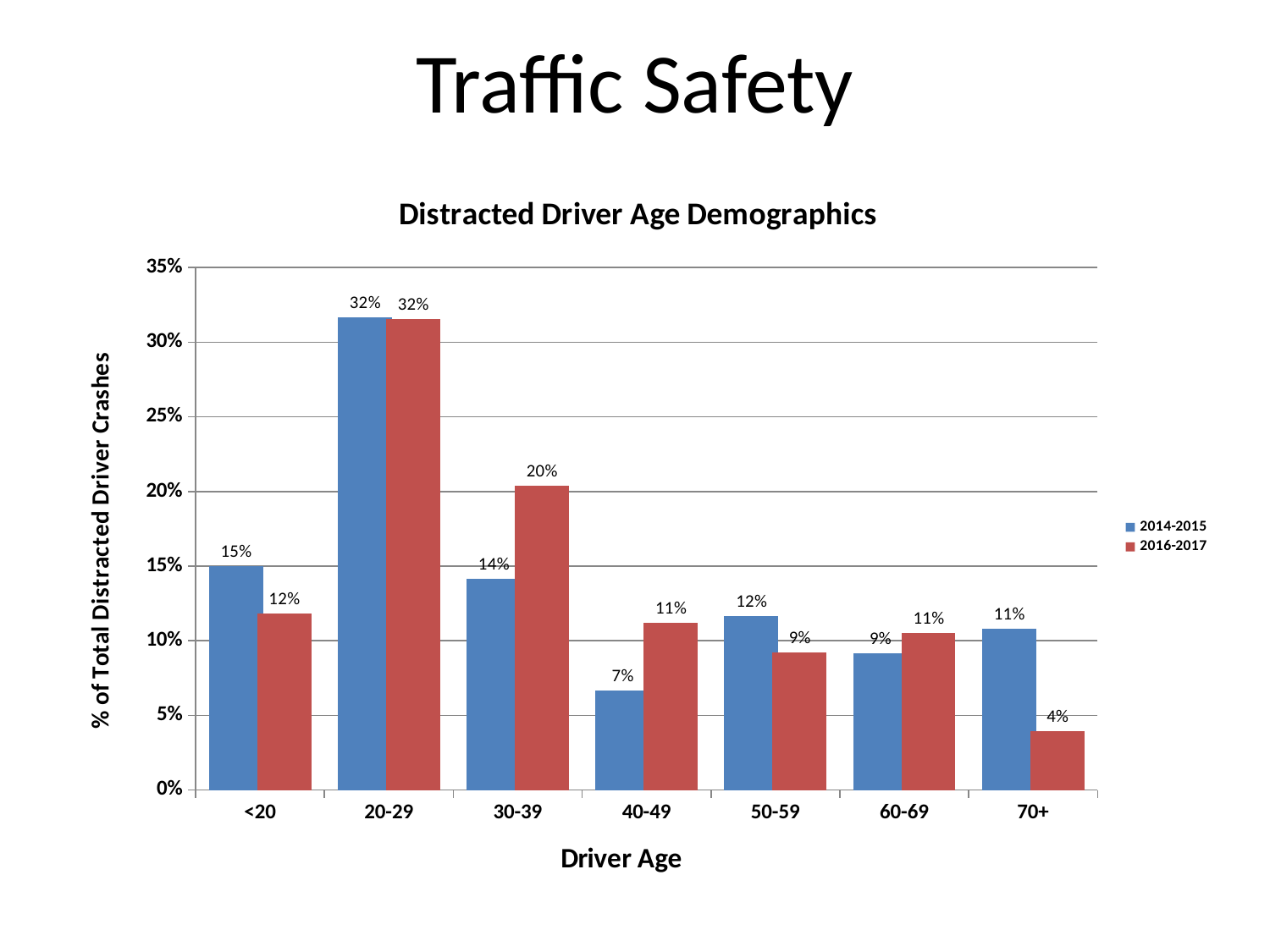
What is the difference between the 2016-2017 and 2014-2015 values for the 30-39 age group? 6 percentage points In the 50-59 age group, which series has the larger value, 2014-2015 or 2016-2017? 2014-2015 How many age groups are shown on the x axis? 7 What kind of chart is shown on the slide? Bar chart How many series does the legend list? 2 What is the value for the 2016-2017 series in the 30-39 age group? 20% What is the value for the 2014-2015 series in the <20 age group? 15% Which age group has the lowest value for the 2016-2017 series? 70+ Which age group has the highest value for the 2014-2015 series? 20-29 Is the 2014-2015 value for the 40-49 age group greater or less than 10%? less What is the value for the 2016-2017 series in the 70+ age group? 4% Which age group has the lowest value for the 2014-2015 series? 40-49